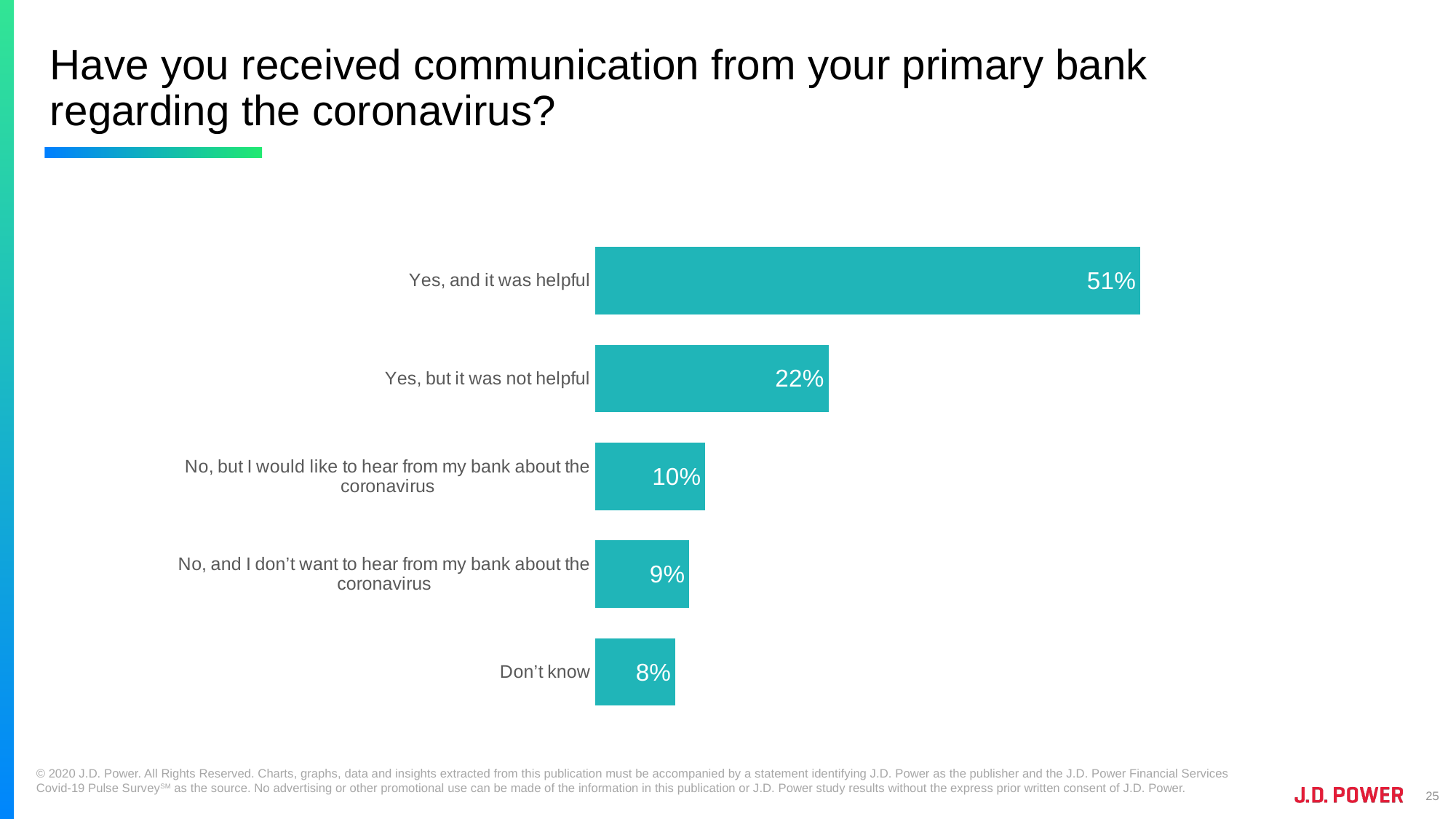
What type of chart is shown on the slide? Bar chart What percentage of respondents said "Yes, and it was helpful"? 51% What percentage of respondents said "No, but I would like to hear from my bank about the coronavirus"? 10% Which response has the lowest percentage? Don't know Which response has the highest percentage? Yes, and it was helpful What is the title of the slide? Have you received communication from your primary bank regarding the coronavirus? Which is larger: the value for "No, but I would like to hear from my bank about the coronavirus" or the value for "No, and I don't want to hear from my bank about the coronavirus"? No, but I would like to hear from my bank about the coronavirus How many response categories are shown in the chart? 5 What percentage of respondents answered "Don't know"? 8% What is the difference in percentage points between "Yes, and it was helpful" and "Yes, but it was not helpful"? 29 percentage points What percentage of respondents said "Yes, but it was not helpful"? 22% What is the combined percentage of respondents who said they received communication from their bank (both "Yes" responses)? 73%